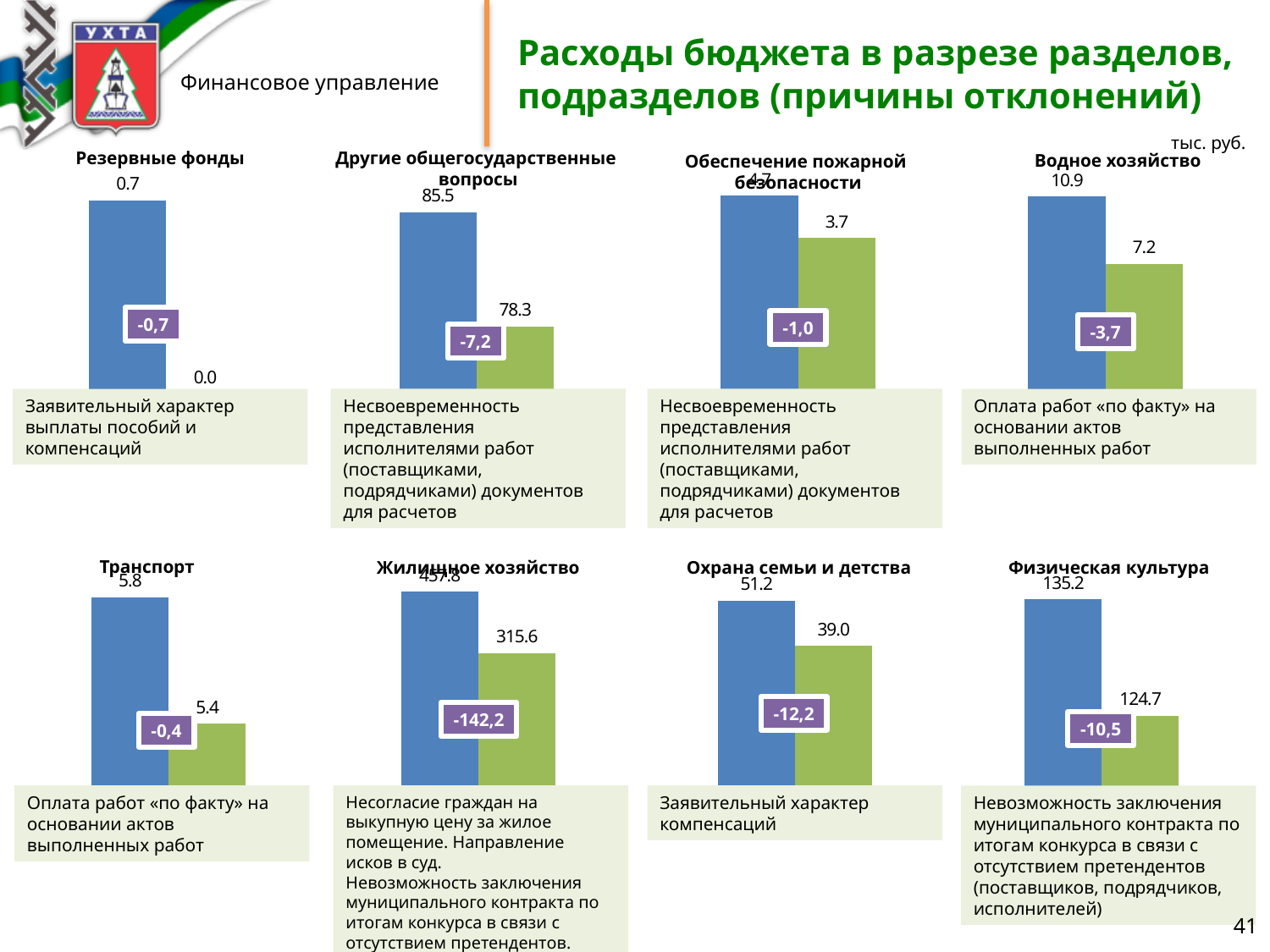
In the 'Охрана семьи и детства' chart, what is the value of the green bar? 39.0 In the 'Водное хозяйство' chart, what is the value of the blue bar? 10.9 How many bars are plotted in the 'Другие общегосударственные вопросы' chart? 2 In the 'Резервные фонды' chart, what is the value of the blue bar? 0.7 In the 'Жилищное хозяйство' chart, what is the value of the green bar? 315.6 In the 'Водное хозяйство' chart, what is the difference between the blue bar and the green bar? 3.7 In the 'Другие общегосударственные вопросы' chart, what is the value of the green bar? 78.3 In the 'Транспорт' chart, what is the difference between the blue bar (5.8) and the green bar (5.4)? 0.4 In the 'Физическая культура' chart, what is the value of the blue bar? 135.2 In the 'Охрана семьи и детства' chart, which bar is larger, the blue one or the green one? the blue one What deviation value is shown in the purple label on the 'Жилищное хозяйство' chart? -142,2 What type of chart is used for 'Физическая культура'? bar chart